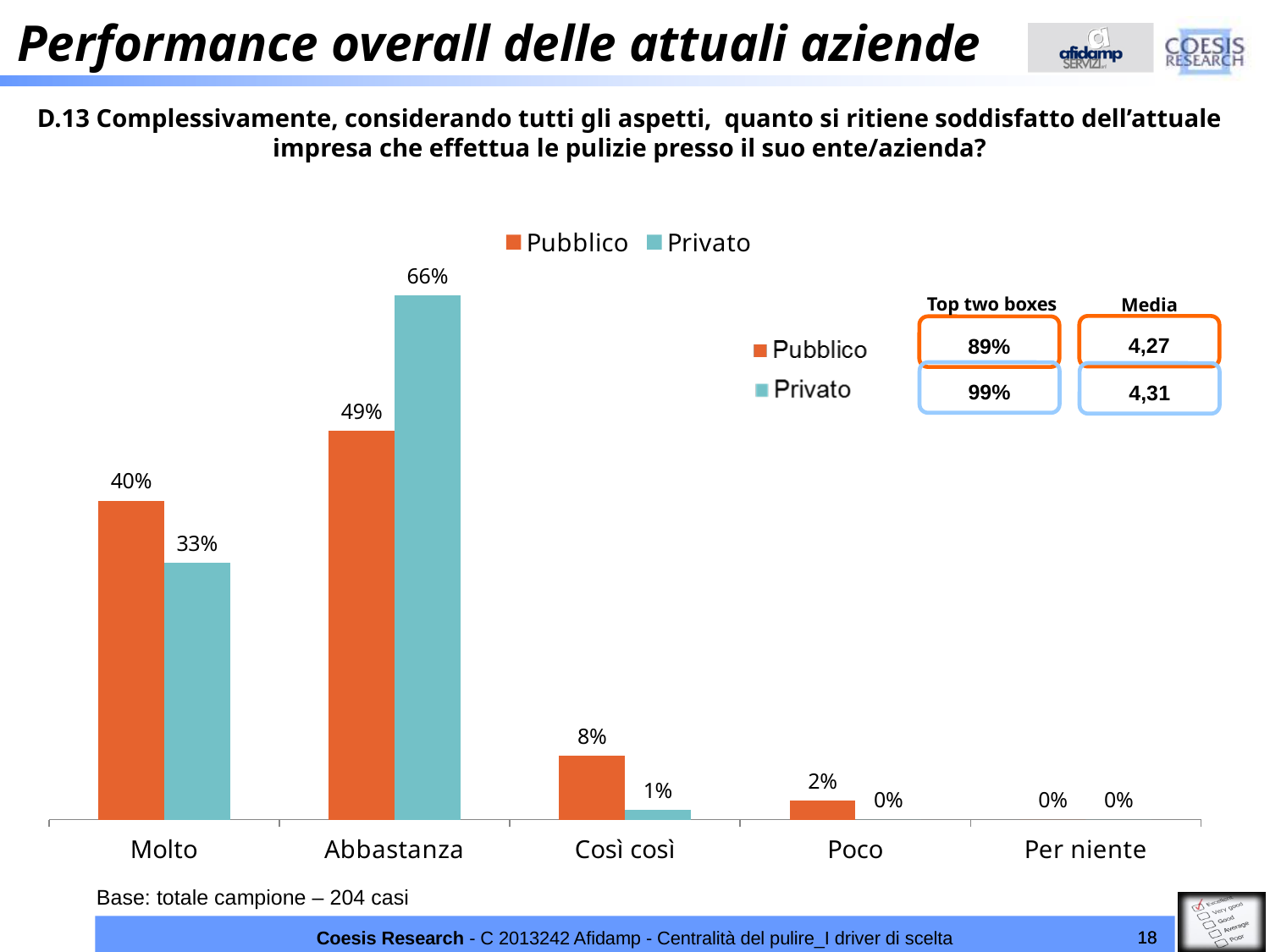
Which category has the lowest value for the Pubblico series? Per niente Which category has the highest value for the Privato series? Abbastanza How many categories are shown on the x axis? 5 What is the value for Privato in the Così così category? 1% What is the difference between the Privato and Pubblico values in the Abbastanza category? 17% What is the value for Pubblico in the Poco category? 2% In the Molto category, which series has the larger value, Pubblico or Privato? Pubblico What is the value for Pubblico in the Molto category? 40% What is the value for Privato in the Abbastanza category? 66% What kind of chart is shown on the slide? Bar chart How many series does the legend list? 2 What is the Top two boxes value for Privato shown in the table on the right? 99%